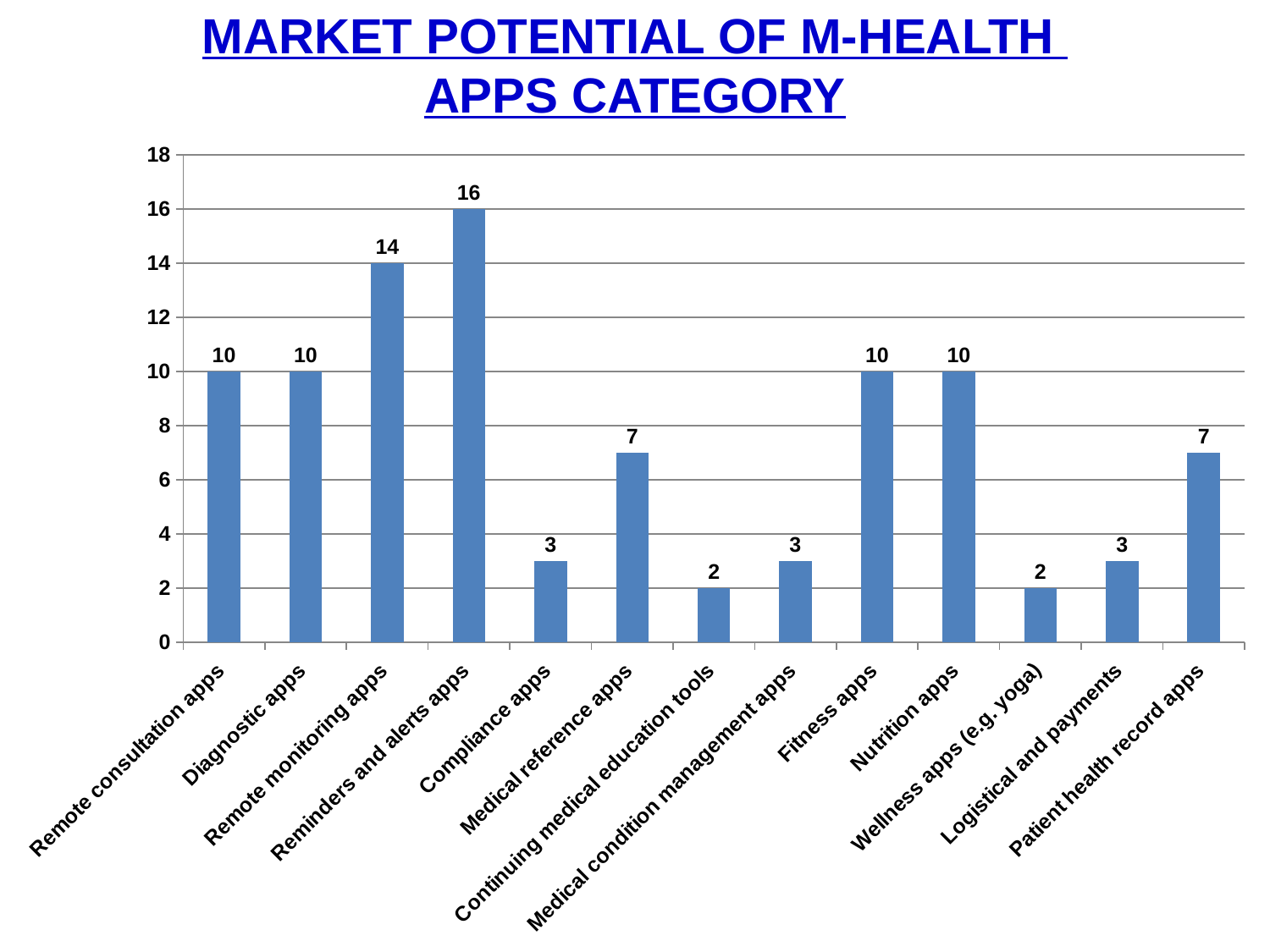
Is the value for Remote monitoring apps greater or less than 12? greater What is the value for Medical reference apps? 7 What is the value for Wellness apps (e.g. yoga)? 2 Which category has the highest value? Reminders and alerts apps What is the value for Remote monitoring apps? 14 What kind of chart is shown on the slide? bar chart How many categories are shown on the x axis? 13 Which is larger, the value for Patient health record apps or the value for Logistical and payments? Patient health record apps What is the difference between the values for Fitness apps and Compliance apps? 7 What is the title of the chart on the slide? MARKET POTENTIAL OF M-HEALTH APPS CATEGORY What is the value for Reminders and alerts apps? 16 What is the difference between the values for Reminders and alerts apps and Remote monitoring apps? 2